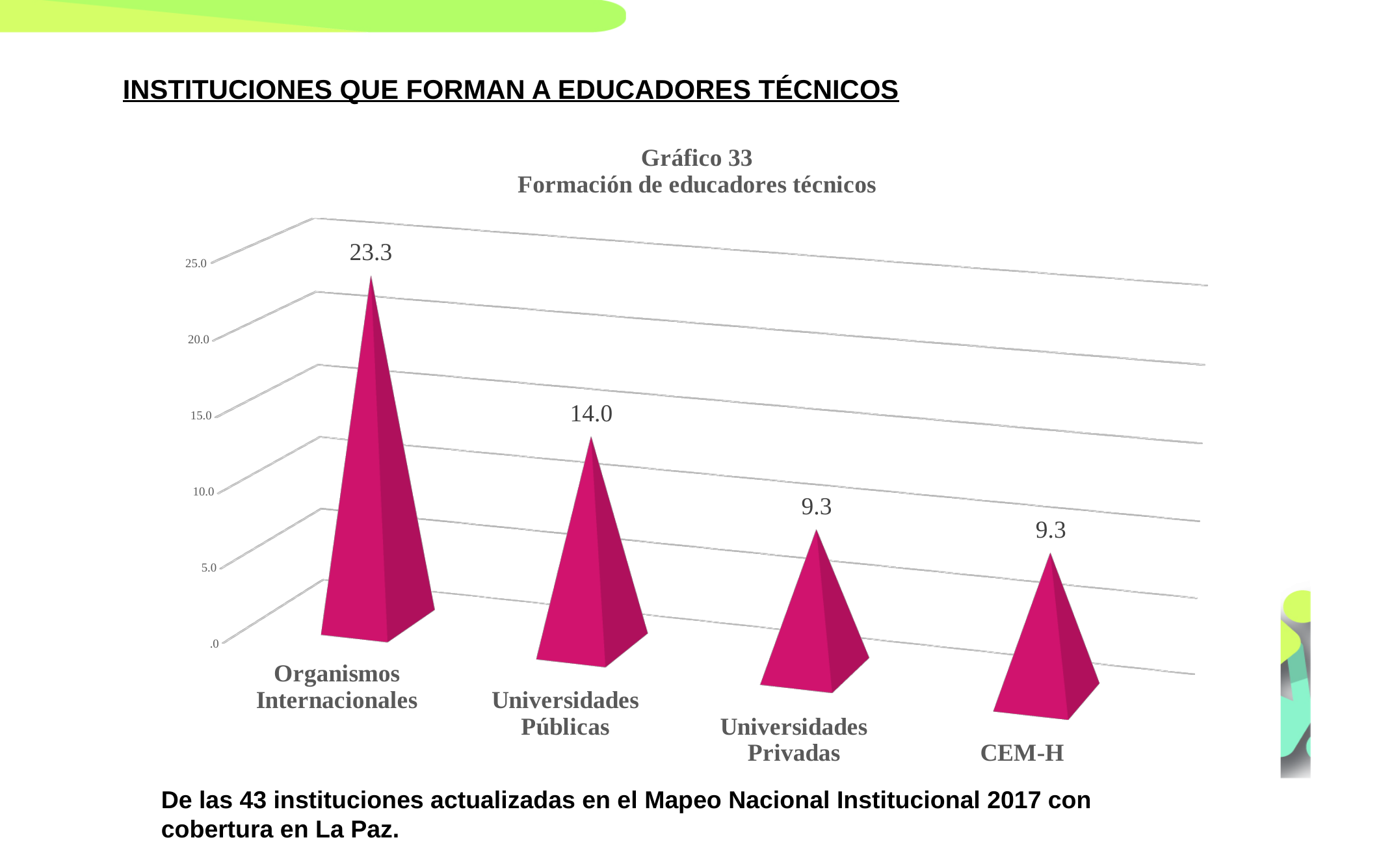
Which category has the highest value? Organismos Internacionales What is the difference between the values for Universidades Públicas and CEM-H? 4.7 What is the value for Universidades Públicas? 14.0 What is the value for Organismos Internacionales? 23.3 How many categories are shown in the chart? 4 Is the value for Organismos Internacionales greater or less than 20.0? greater What is the value for CEM-H? 9.3 What is the difference between the values for Organismos Internacionales and Universidades Públicas? 9.3 What is the value for Universidades Privadas? 9.3 What is the title of the chart? Gráfico 33 Formación de educadores técnicos What kind of chart is shown on the slide? bar chart Which is larger, the value for Universidades Públicas or the value for Universidades Privadas? Universidades Públicas